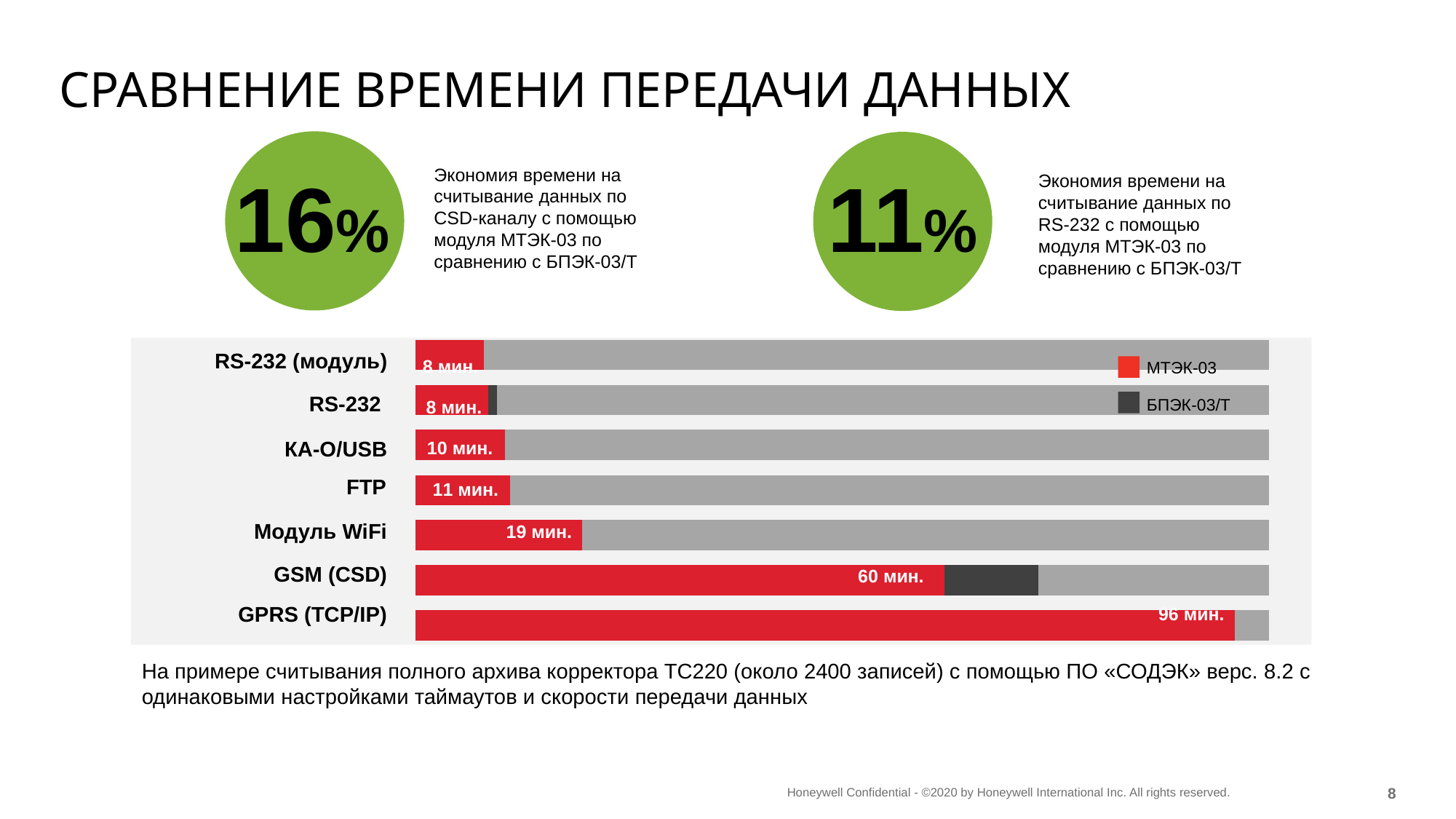
What is the difference between the МТЭК-03 values for GPRS (TCP/IP) and GSM (CSD)? 36 мин. What is the МТЭК-03 value for Модуль WiFi? 19 мин. What type of chart is shown on the slide? bar chart What is the МТЭК-03 value for FTP? 11 мин. Which series is shown in red in the legend? МТЭК-03 Which category has the highest МТЭК-03 value? GPRS (TCP/IP) What is the МТЭК-03 value for КА-О/USB? 10 мин. Which has the larger МТЭК-03 value, FTP or КА-О/USB? FTP How many categories are plotted in the chart? 7 What is the МТЭК-03 value for GPRS (TCP/IP)? 96 мин. How many series does the chart legend list? 2 What is the МТЭК-03 value for GSM (CSD)? 60 мин.